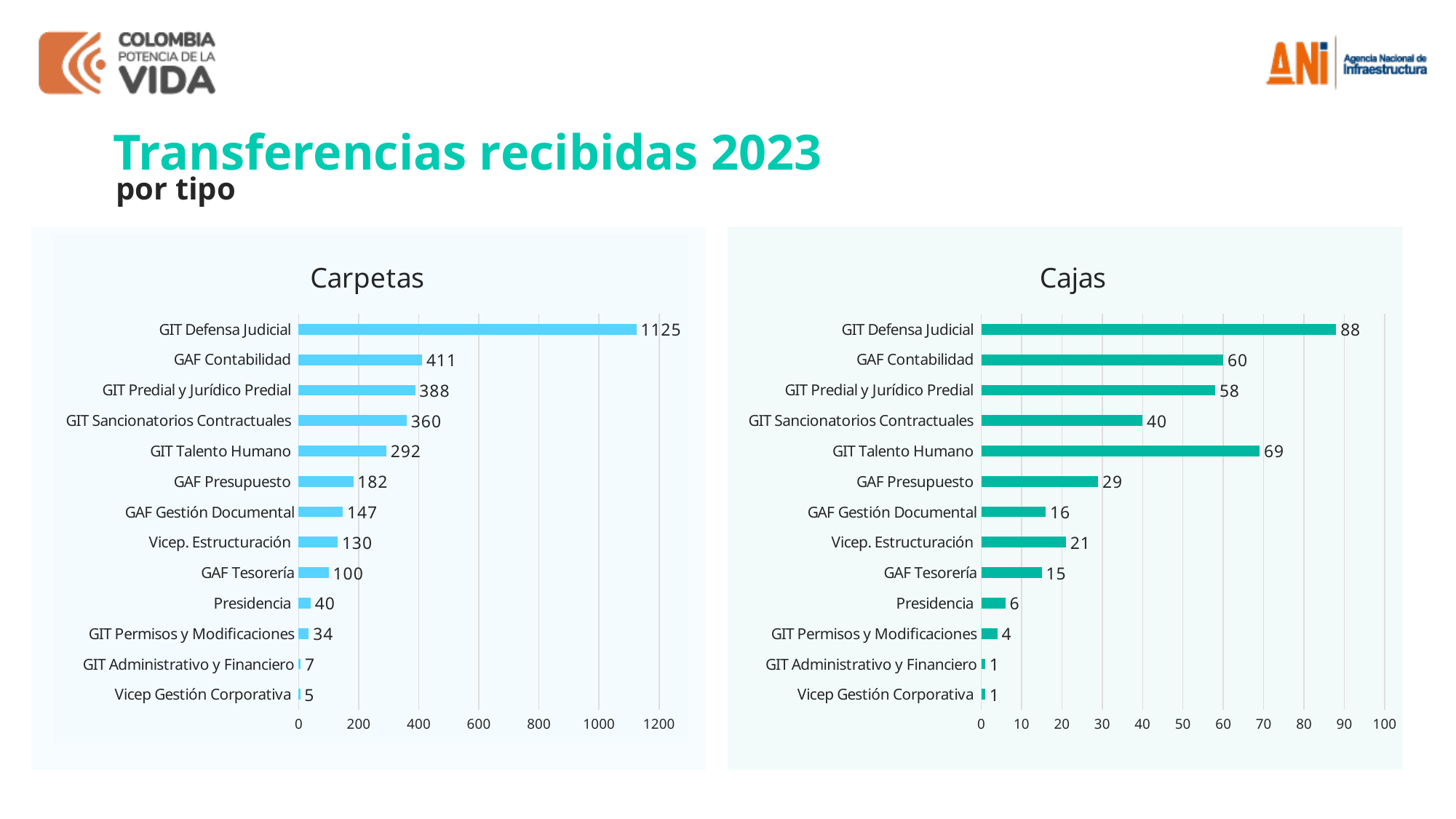
In the Carpetas chart, which category has the lowest value? Vicep Gestión Corporativa In the Cajas chart, what is the difference between GIT Defensa Judicial and GAF Contabilidad? 28 What is the title of the chart on the right side of the slide? Cajas In the Cajas chart, which category has the highest value? GIT Defensa Judicial What kind of chart is the Carpetas chart? Bar chart In the Carpetas chart, what is the difference between GAF Contabilidad and GIT Predial y Jurídico Predial? 23 In the Cajas chart, which is larger: GIT Talento Humano or GAF Contabilidad? GIT Talento Humano In the Carpetas chart, what is the value for GAF Tesorería? 100 How many categories are shown in the Cajas chart? 13 In the Cajas chart, what is the value for GIT Talento Humano? 69 In the Carpetas chart, what is the value for GIT Defensa Judicial? 1125 In the Carpetas chart, which is larger: GAF Presupuesto or GAF Gestión Documental? GAF Presupuesto